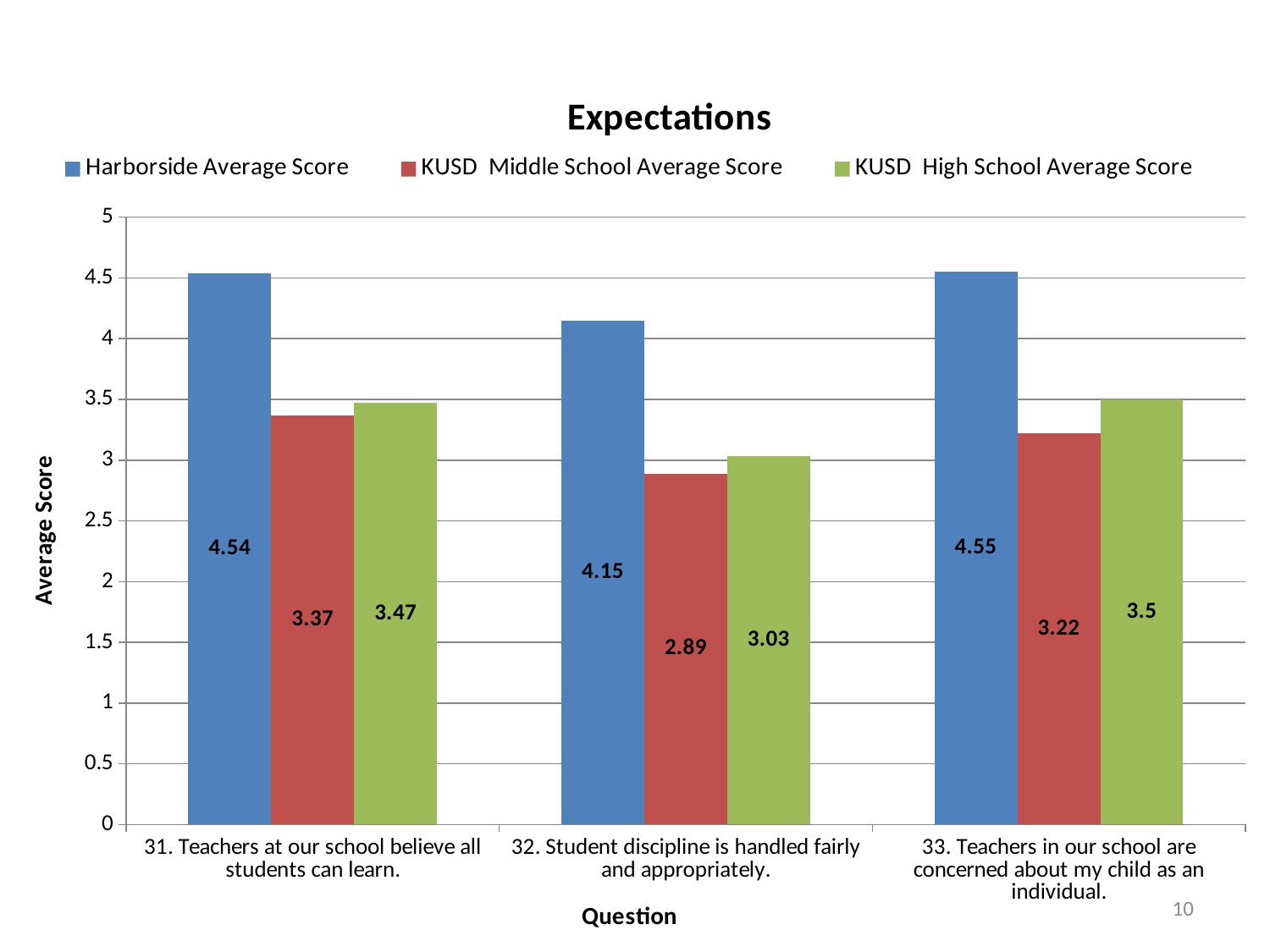
How many series does the legend list? 3 What is the KUSD Middle School Average Score for question 32 (Student discipline is handled fairly and appropriately)? 2.89 How many questions (categories) are shown on the x axis? 3 What is the KUSD High School Average Score for question 33 (Teachers in our school are concerned about my child as an individual)? 3.5 What is the title of the chart? Expectations Which question has the lowest KUSD Middle School Average Score? 32. Student discipline is handled fairly and appropriately. What kind of chart is shown on the slide? Bar chart Which question has the highest Harborside Average Score? 33. Teachers in our school are concerned about my child as an individual. What is the Harborside Average Score for question 31 (Teachers at our school believe all students can learn)? 4.54 What is the difference between the Harborside Average Score and the KUSD Middle School Average Score for question 32? 1.26 For question 31, which is larger: the KUSD Middle School Average Score or the KUSD High School Average Score? KUSD High School Average Score Is the Harborside Average Score for question 32 greater or less than 4? greater